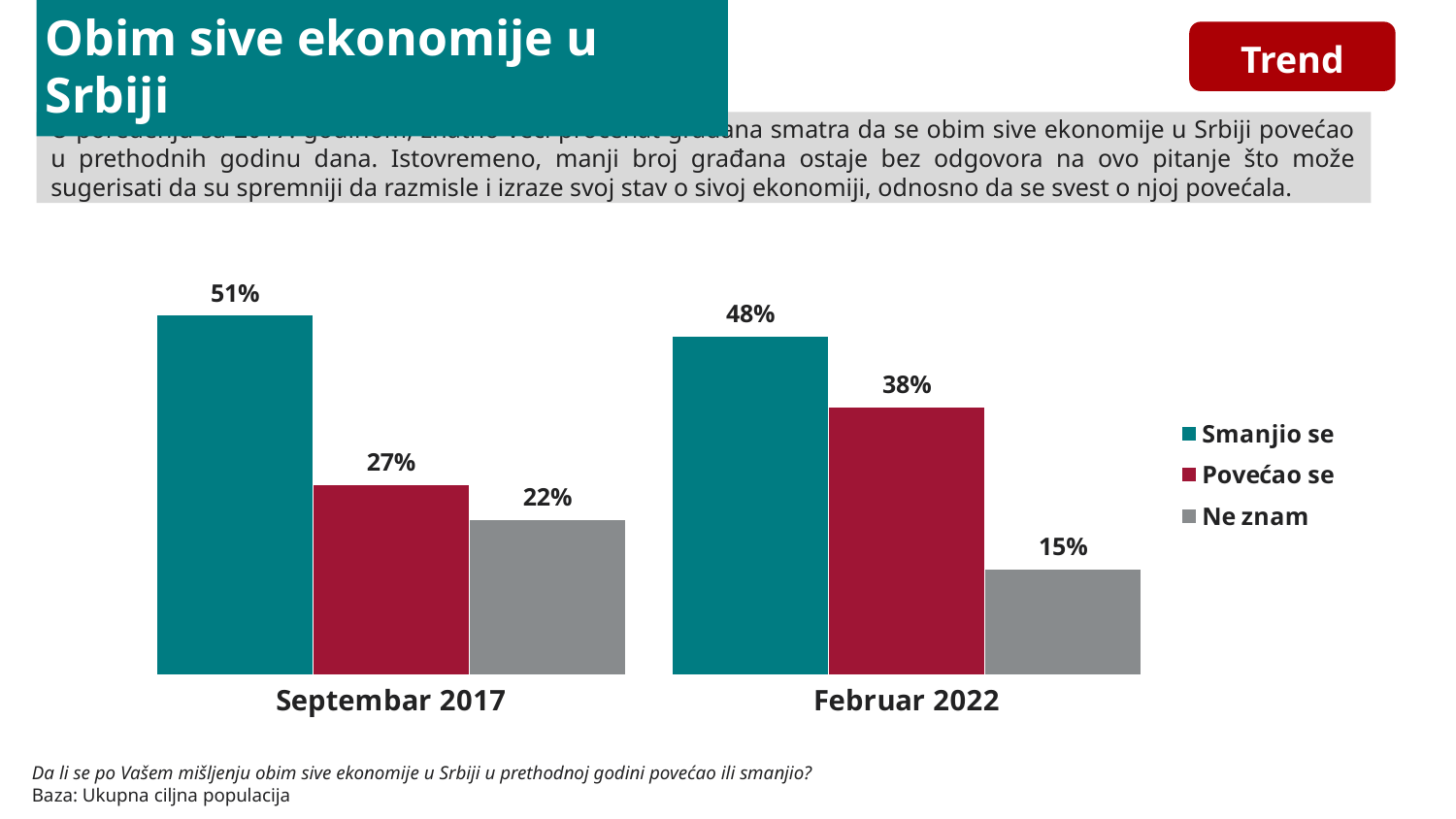
What is the value for "Smanjio se" in Septembar 2017? 51% Does the value for "Smanjio se" rise or fall from Septembar 2017 to Februar 2022? Fall What is the difference between "Povećao se" in Februar 2022 and "Povećao se" in Septembar 2017? 11% Which series has the lowest value in Septembar 2017? Ne znam What is the value for "Ne znam" in Februar 2022? 15% What is the value for "Povećao se" in Februar 2022? 38% Which is larger: "Ne znam" in Septembar 2017 or "Ne znam" in Februar 2022? Septembar 2017 Which series has the highest value in Februar 2022? Smanjio se What is the value for "Povećao se" in Septembar 2017? 27% How many categories are shown on the x axis? 2 What kind of chart is shown on the slide? Bar chart How many series does the legend list? 3